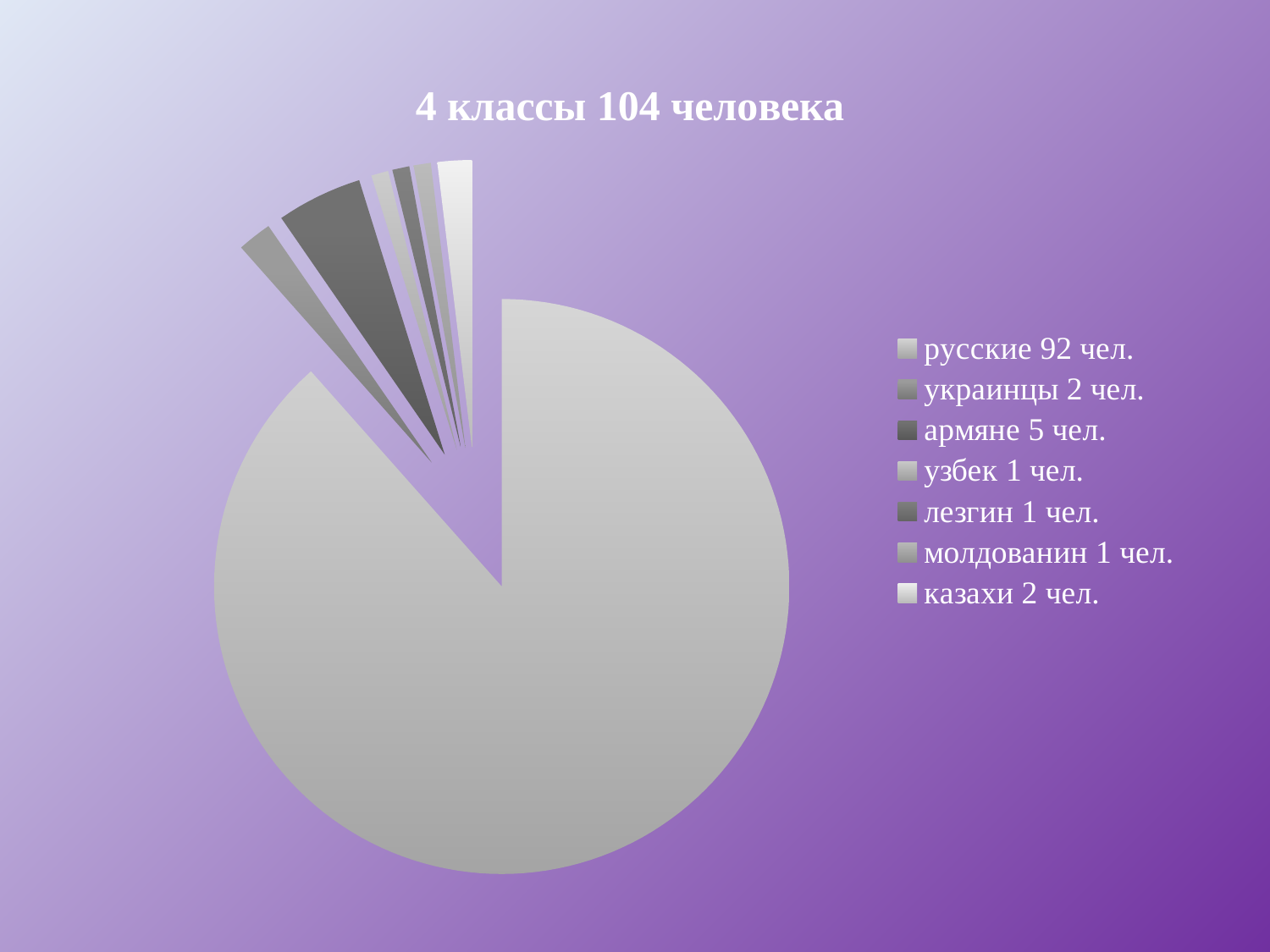
How many people are in the казахи category? 2 чел. How many categories have a value of 1 чел.? 3 How many categories does the pie chart have? 7 What kind of chart is shown on the slide? pie chart Which category has the largest slice of the pie? русские Which is larger, армяне or украинцы? армяне How many people are in the украинцы category? 2 чел. How many people are in the армяне category? 5 чел. How many people are in the русские category? 92 чел. What is the total of all the categories in the pie chart? 104 What is the difference between the русские and армяне values? 87 What is the title of the chart? 4 классы 104 человека